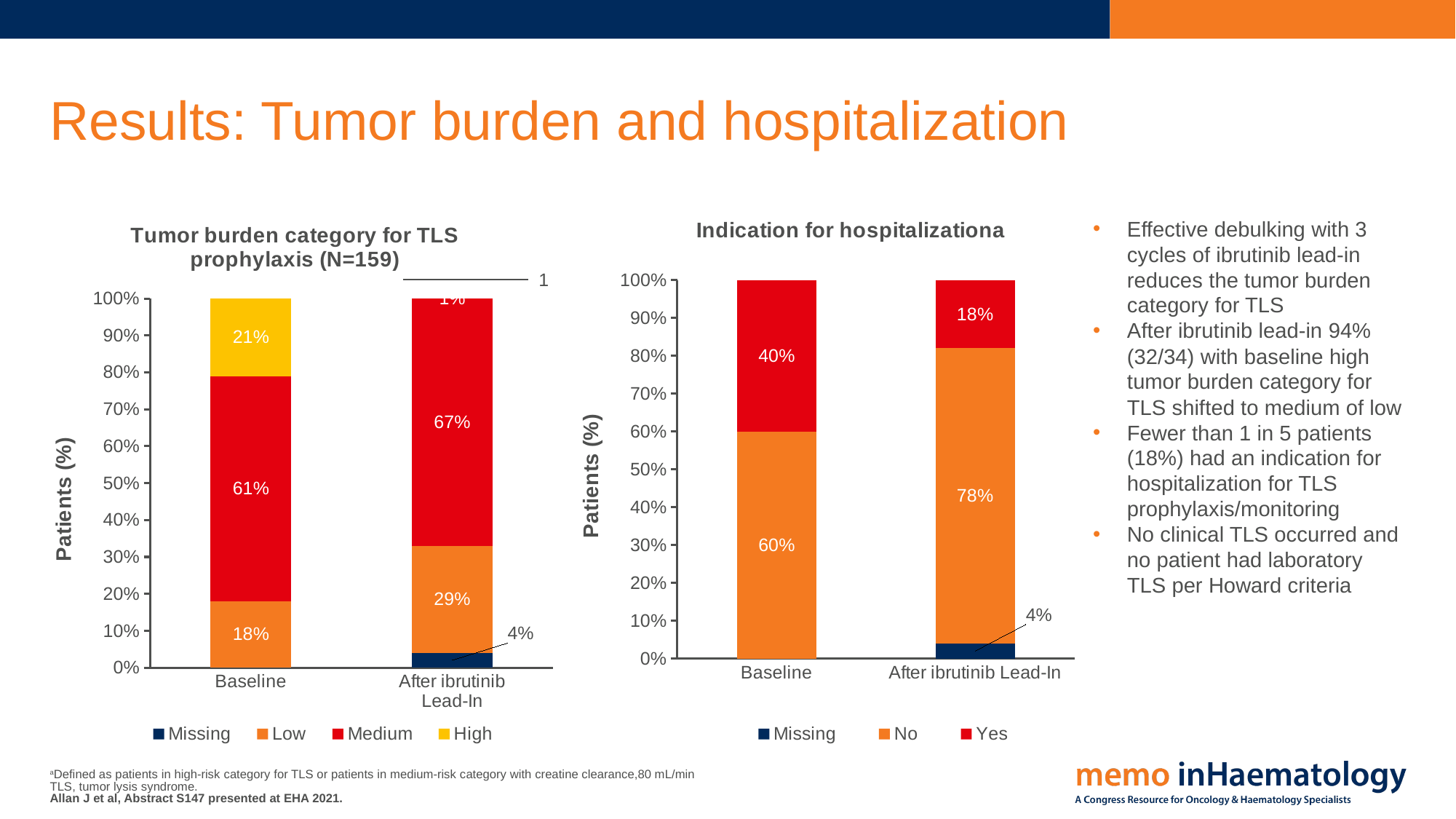
In the 'Tumor burden category for TLS prophylaxis (N=159)' chart, what is the difference between the Low percentage After ibrutinib Lead-In and at Baseline? 11% How many series does the legend of the 'Tumor burden category for TLS prophylaxis (N=159)' chart list? 4 In the 'Indication for hospitalization' chart, what percentage of patients had 'Yes' at Baseline? 40% In the 'Indication for hospitalization' chart, what is the difference between the 'Yes' percentage at Baseline and After ibrutinib Lead-In? 22% In the 'Tumor burden category for TLS prophylaxis (N=159)' chart, what percentage of patients were in the Medium category at Baseline? 61% In the 'Tumor burden category for TLS prophylaxis (N=159)' chart, what percentage of patients were in the High category at Baseline? 21% What type of chart is the 'Indication for hospitalization' chart? Stacked bar chart In the 'Tumor burden category for TLS prophylaxis (N=159)' chart, which category has the largest share at Baseline? Medium In the 'Indication for hospitalization' chart, what percentage of patients were Missing After ibrutinib Lead-In? 4% In the 'Indication for hospitalization' chart, is the 'No' share larger at Baseline or After ibrutinib Lead-In? After ibrutinib Lead-In In the 'Tumor burden category for TLS prophylaxis (N=159)' chart, what percentage of patients were in the Low category After ibrutinib Lead-In? 29% In the 'Indication for hospitalization' chart, what percentage of patients had 'No' After ibrutinib Lead-In? 78%